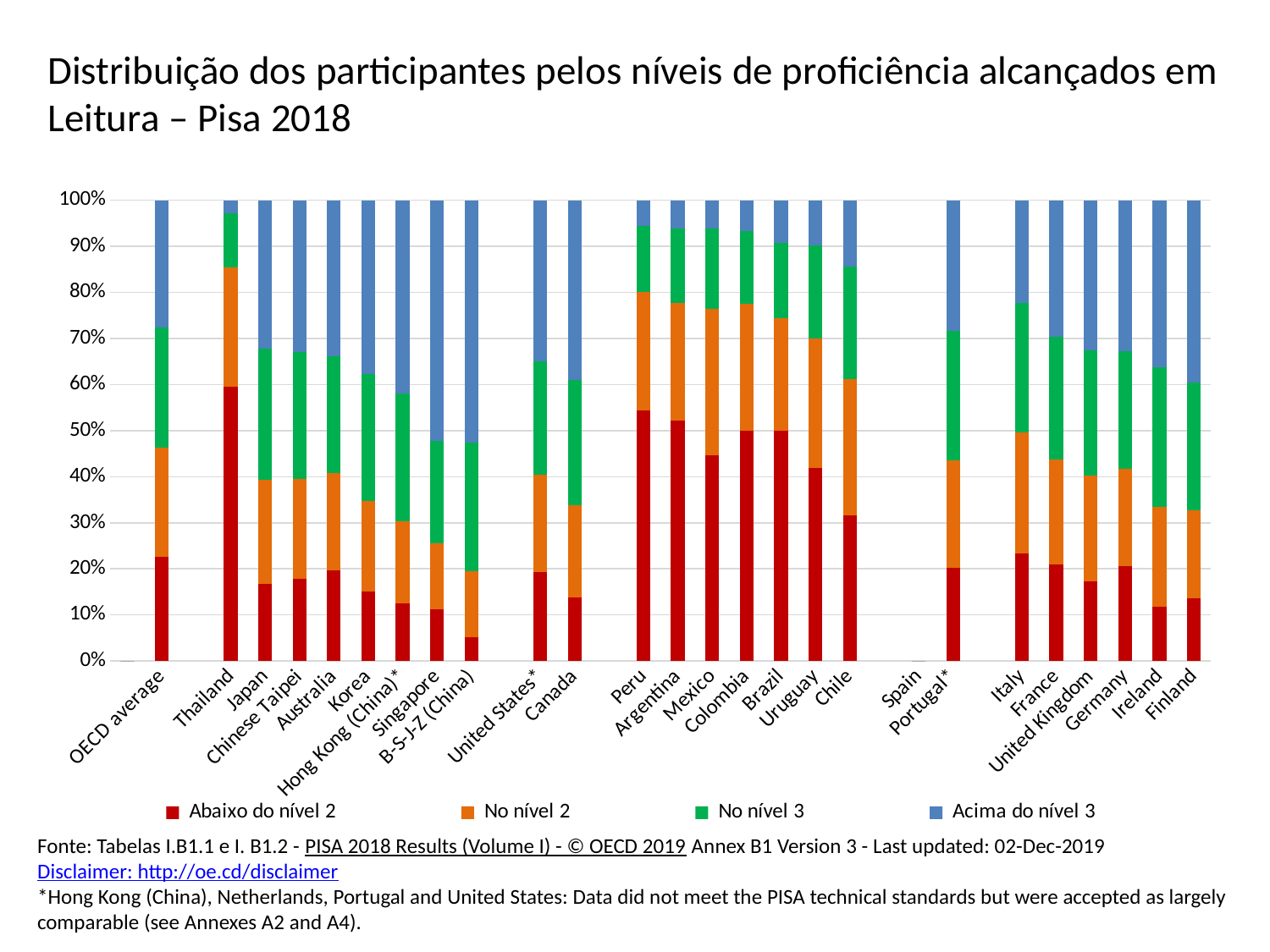
What kind of chart is shown on the slide? Stacked bar chart How many series does the legend list? 4 Which has a larger 'Abaixo do nível 2' share, Thailand or Japan? Thailand Is the 'Abaixo do nível 2' value for Finland greater or less than 20%? less Is the 'Abaixo do nível 2' value for Peru greater or less than 50%? greater Which country label on the x axis has no bar plotted above it? Spain Which country has the highest share in the 'Abaixo do nível 2' series? Thailand Which country has the smallest 'Acima do nível 3' segment? Thailand Is the 'Abaixo do nível 2' value for Thailand greater or less than 50%? greater Which has a larger 'Abaixo do nível 2' share, Peru or Chile? Peru Which country has the lowest share in the 'Abaixo do nível 2' series? B-S-J-Z (China)